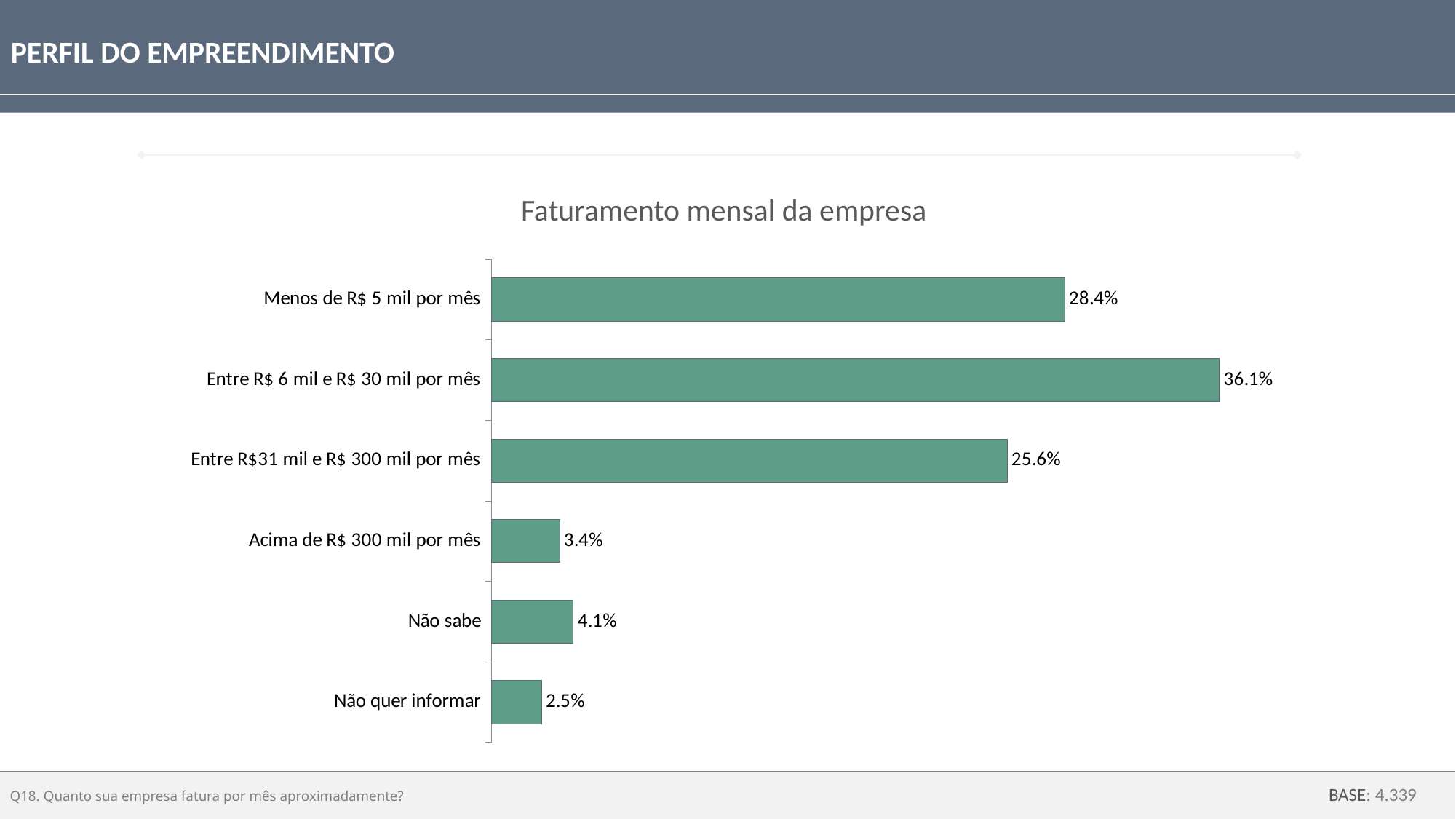
Which category has the lowest value? Não quer informar What is the value for "Entre R$ 6 mil e R$ 30 mil por mês"? 36.1% What is the value for "Não quer informar"? 2.5% Which is larger: "Menos de R$ 5 mil por mês" or "Entre R$31 mil e R$ 300 mil por mês"? Menos de R$ 5 mil por mês What is the value for "Menos de R$ 5 mil por mês"? 28.4% What is the title of the chart? Faturamento mensal da empresa Which category has the highest value? Entre R$ 6 mil e R$ 30 mil por mês What kind of chart is shown on the slide? Bar chart What is the difference between "Não sabe" and "Acima de R$ 300 mil por mês"? 0.7% What is the value for "Não sabe"? 4.1% How many categories are shown in the chart? 6 What is the difference between "Entre R$ 6 mil e R$ 30 mil por mês" and "Menos de R$ 5 mil por mês"? 7.7%